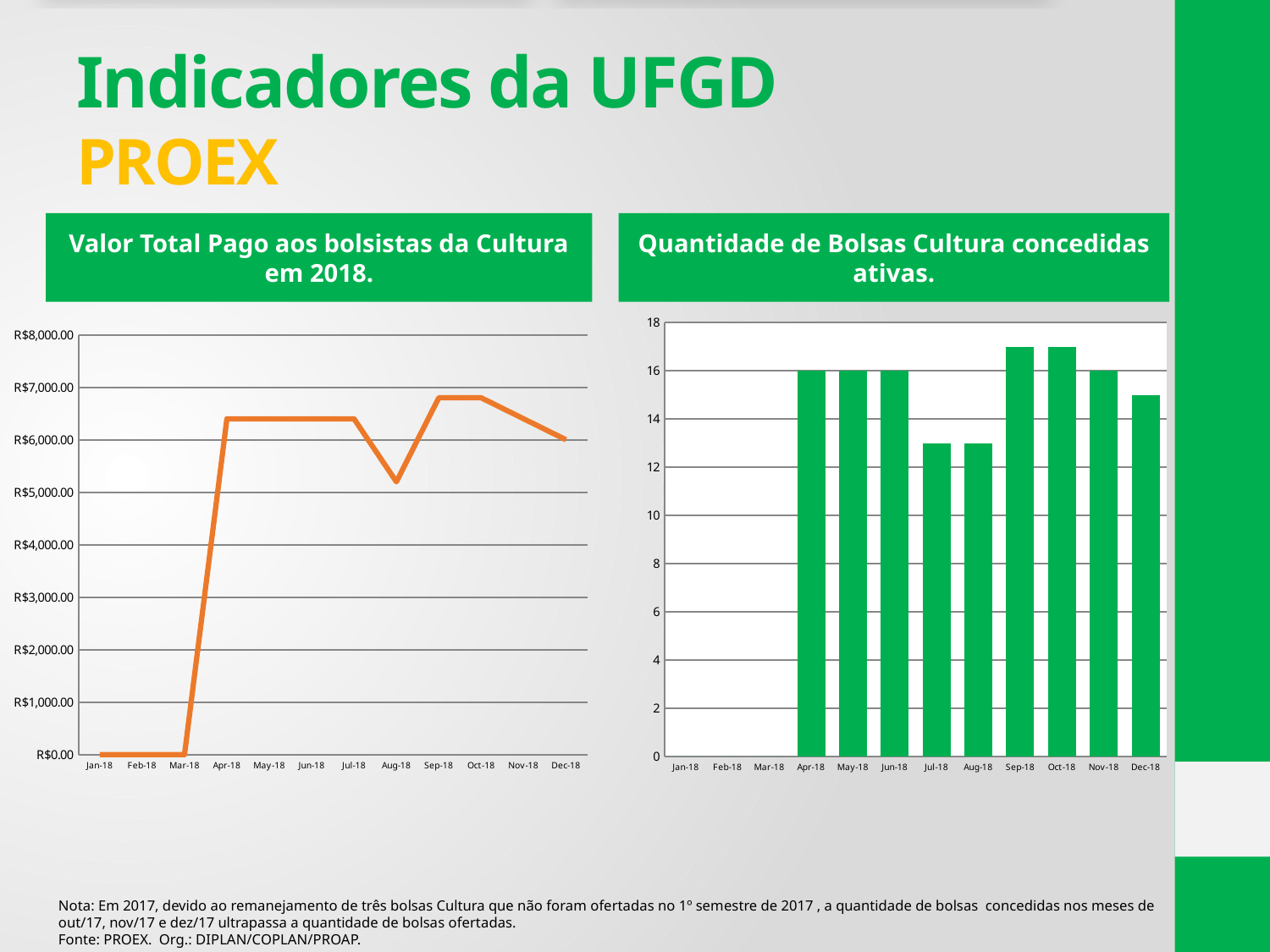
In the right chart 'Quantidade de Bolsas Cultura concedidas ativas.', which is larger, the value for Apr-18 or the value for Jul-18? Apr-18 In the left chart 'Valor Total Pago aos bolsistas da Cultura em 2018.', what is the value for Jan-18? R$0.00 In the left chart 'Valor Total Pago aos bolsistas da Cultura em 2018.', do the values rise or fall from Oct-18 to Dec-18? fall In the right chart 'Quantidade de Bolsas Cultura concedidas ativas.', what is the value for Nov-18? 16 How many months are plotted on the x axis of the left chart 'Valor Total Pago aos bolsistas da Cultura em 2018.'? 12 What kind of chart is the right chart, 'Quantidade de Bolsas Cultura concedidas ativas.'? bar chart In the left chart 'Valor Total Pago aos bolsistas da Cultura em 2018.', is the value for Aug-18 greater or less than R$6,000.00? less In the right chart 'Quantidade de Bolsas Cultura concedidas ativas.', is the value for Jul-18 greater or less than 14? less In the right chart 'Quantidade de Bolsas Cultura concedidas ativas.', what is the value for Apr-18? 16 In the left chart 'Valor Total Pago aos bolsistas da Cultura em 2018.', is the value for Sep-18 greater or less than R$6,000.00? greater What kind of chart is the left chart, 'Valor Total Pago aos bolsistas da Cultura em 2018.'? line chart In the right chart 'Quantidade de Bolsas Cultura concedidas ativas.', what colour are the bars? green